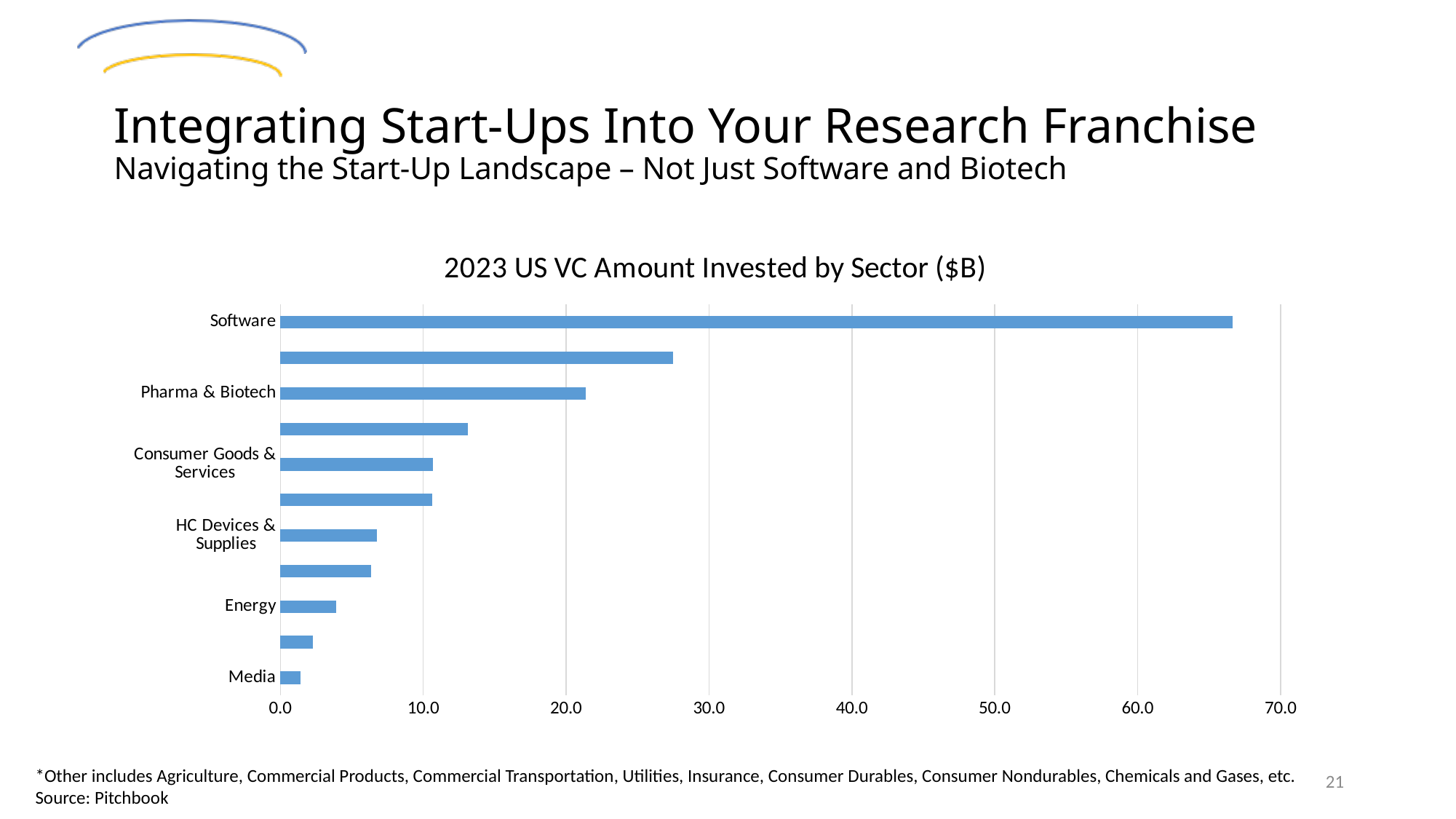
Which is larger, the value for Software or the value for Pharma & Biotech? Software What kind of chart is shown on the slide? Bar chart Which is larger, the value for Energy or the value for Media? Energy Which sector has the highest VC amount invested? Software How many bars are plotted in the chart? 11 Is the value for Energy greater or less than 10.0? less Which labeled sector has the lowest VC amount invested? Media Is the value for Software greater or less than 60.0? greater Is the value for Consumer Goods & Services greater or less than 20.0? less What is the title of the chart? 2023 US VC Amount Invested by Sector ($B)